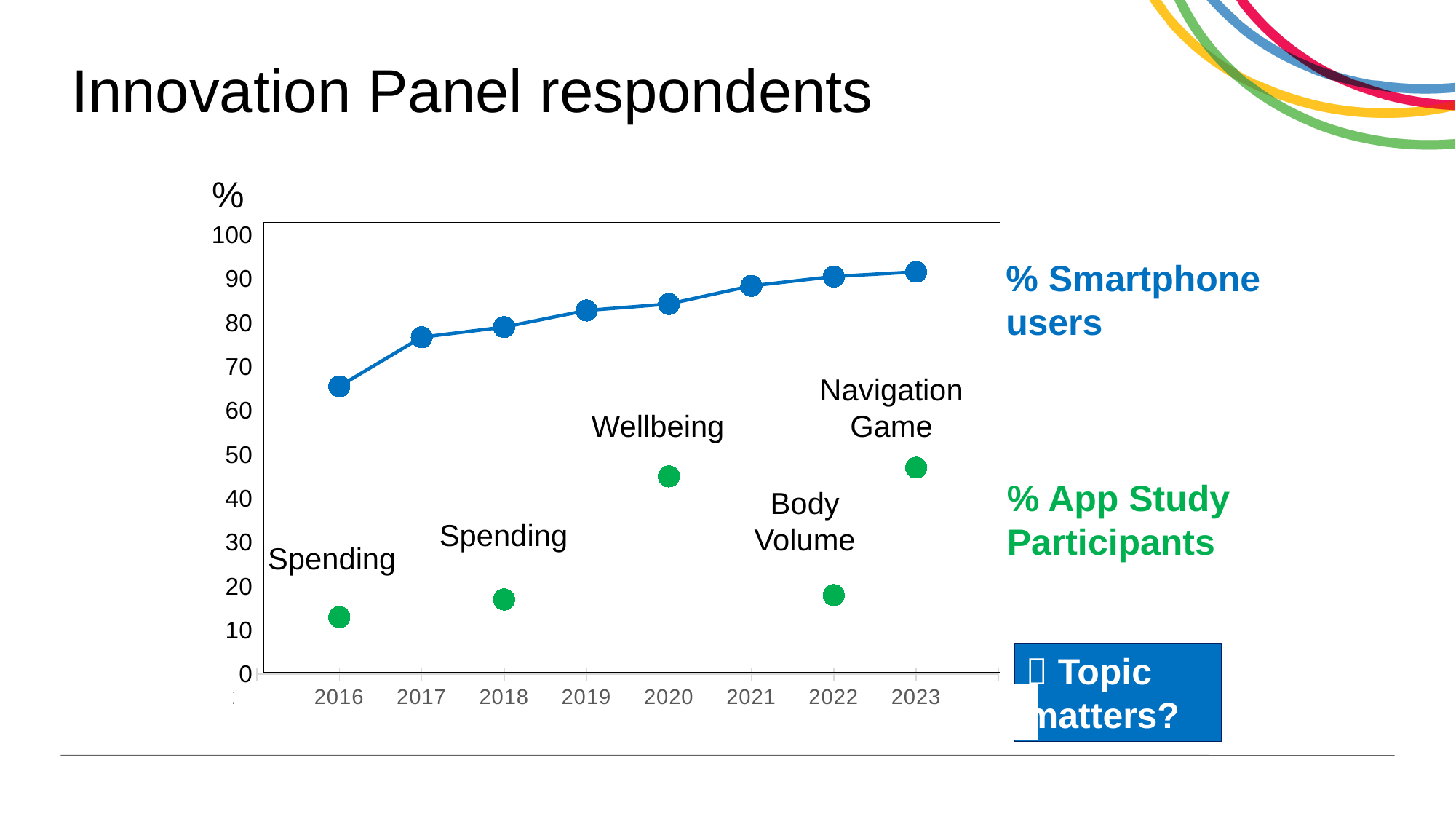
Is the % Smartphone users value for 2021 greater or less than 80? greater Is the % Smartphone users value for 2016 greater or less than 60? greater How many years are shown on the x axis of the chart? 8 Is the % App Study Participants value for 2016 (Spending) greater or less than 20? less In which year is the % Smartphone users value lowest? 2016 Which is larger: the % App Study Participants value for 2020 or for 2016? 2020 Does the % Smartphone users line rise or fall from 2016 to 2023? rise What kind of chart is shown on the slide? line chart Which app study topic is labelled at the 2023 green point? Navigation Game Which app study topic is labelled at the 2022 green point? Body Volume How many green % App Study Participants points are plotted on the chart? 5